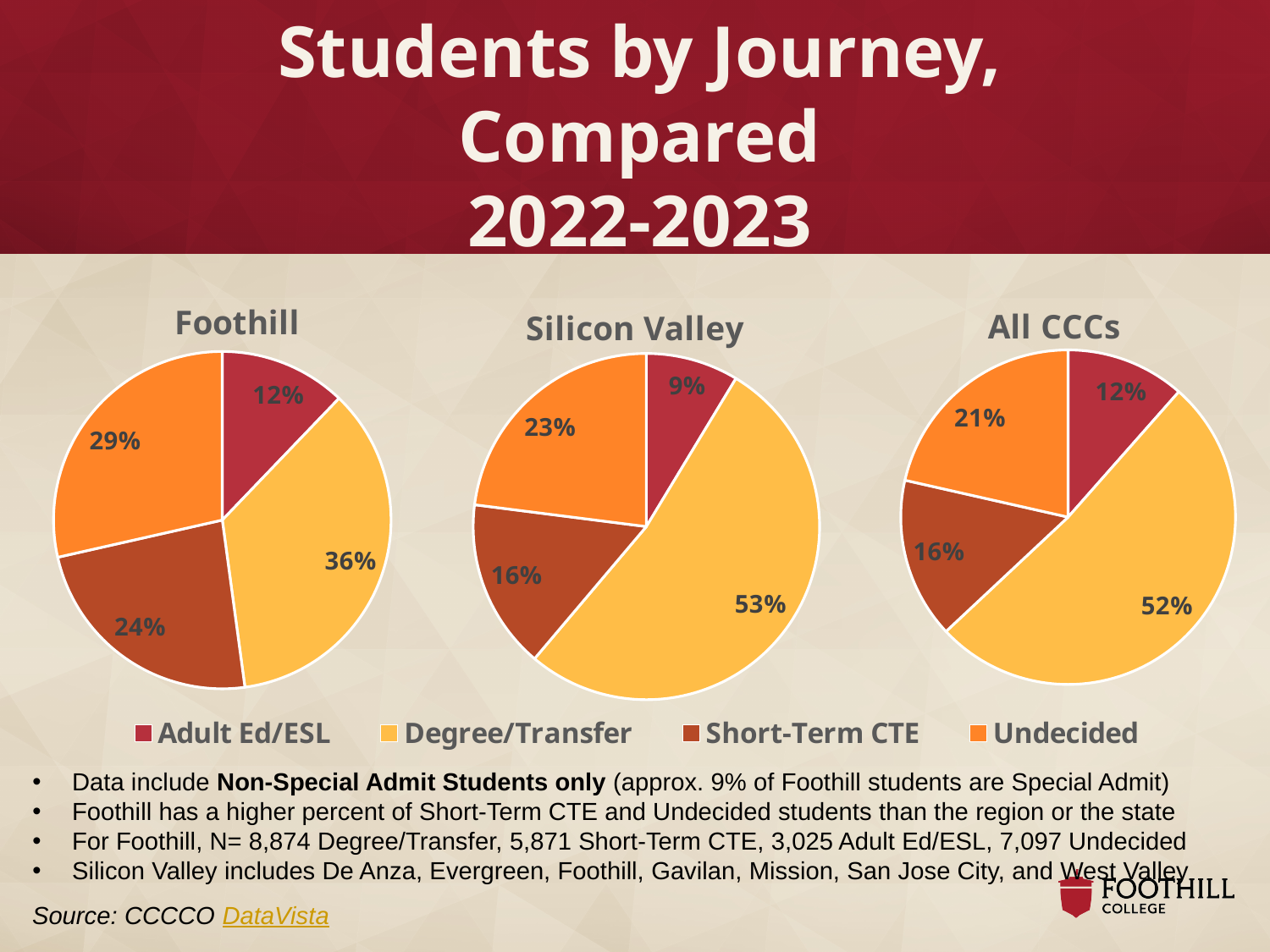
Which legend entry is shown in dark red? Adult Ed/ESL In the All CCCs pie chart, which category has the smallest share? Adult Ed/ESL In the All CCCs pie chart, what share of students are Short-Term CTE? 16% What kind of chart is used to show the Foothill data? Pie chart In the Silicon Valley pie chart, what share of students are Undecided? 23% What is the difference between the Degree/Transfer share in the Silicon Valley chart and the Degree/Transfer share in the Foothill chart? 17% How many pie charts are on the slide? 3 In the Silicon Valley pie chart, what share of students are Adult Ed/ESL? 9% In the Foothill pie chart, which category has the largest share? Degree/Transfer In the Foothill pie chart, what share of students are Degree/Transfer? 36% How many categories does each pie chart show? 4 Which is larger: the Undecided share in the Foothill chart or the Undecided share in the All CCCs chart? Foothill